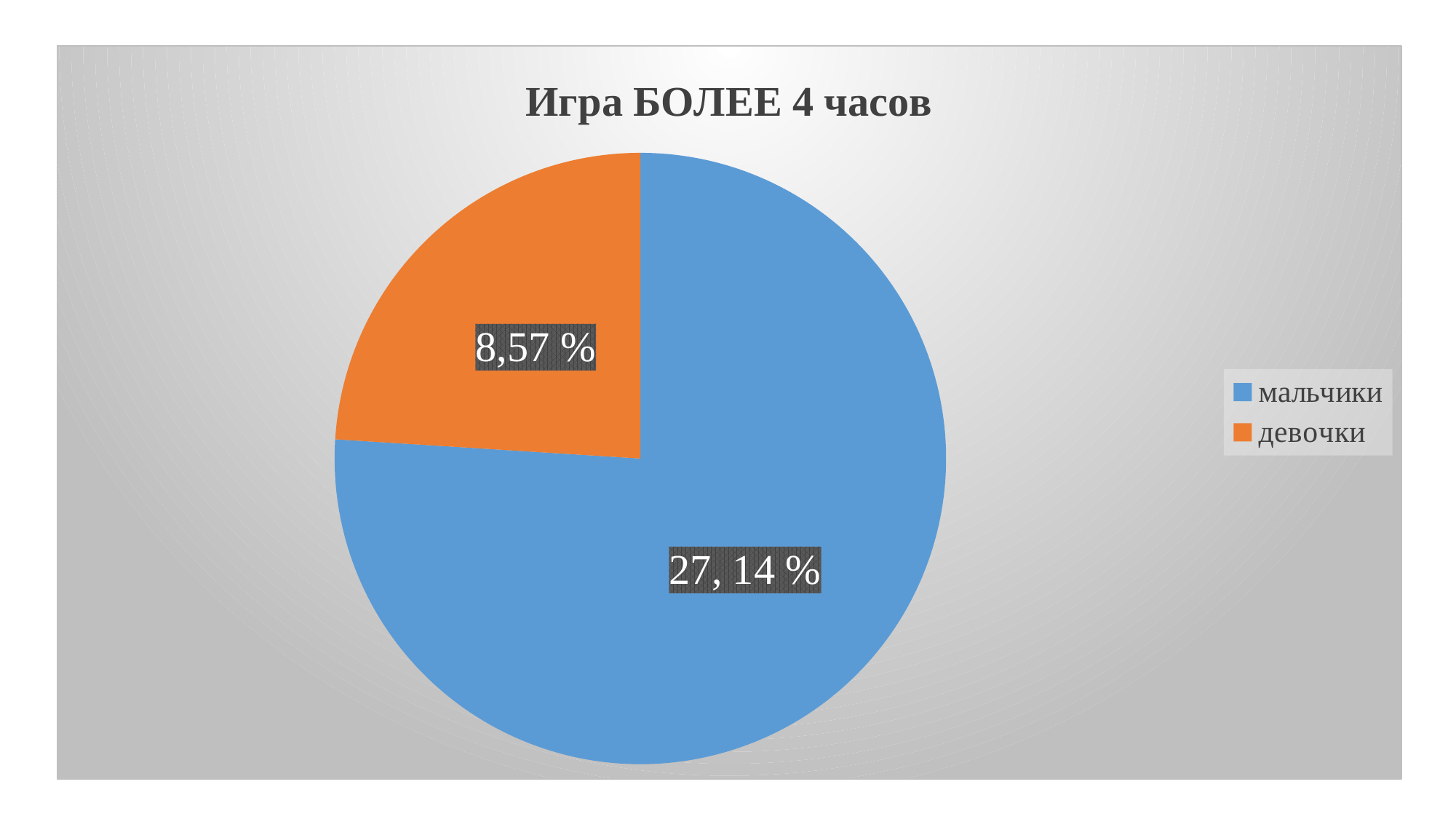
How many entries does the legend list? 2 What is the title of the chart? Игра БОЛЕЕ 4 часов Which category has the largest slice of the pie? мальчики Which category has the smallest slice of the pie? девочки How many slices does the pie chart have? 2 What is the difference between the value for мальчики and the value for девочки? 18,57 % Which is larger, the value for мальчики or the value for девочки? мальчики What value is shown for девочки? 8,57 % What colour is the slice for девочки? orange What value is shown for мальчики? 27, 14 % What type of chart is shown on the slide? pie chart